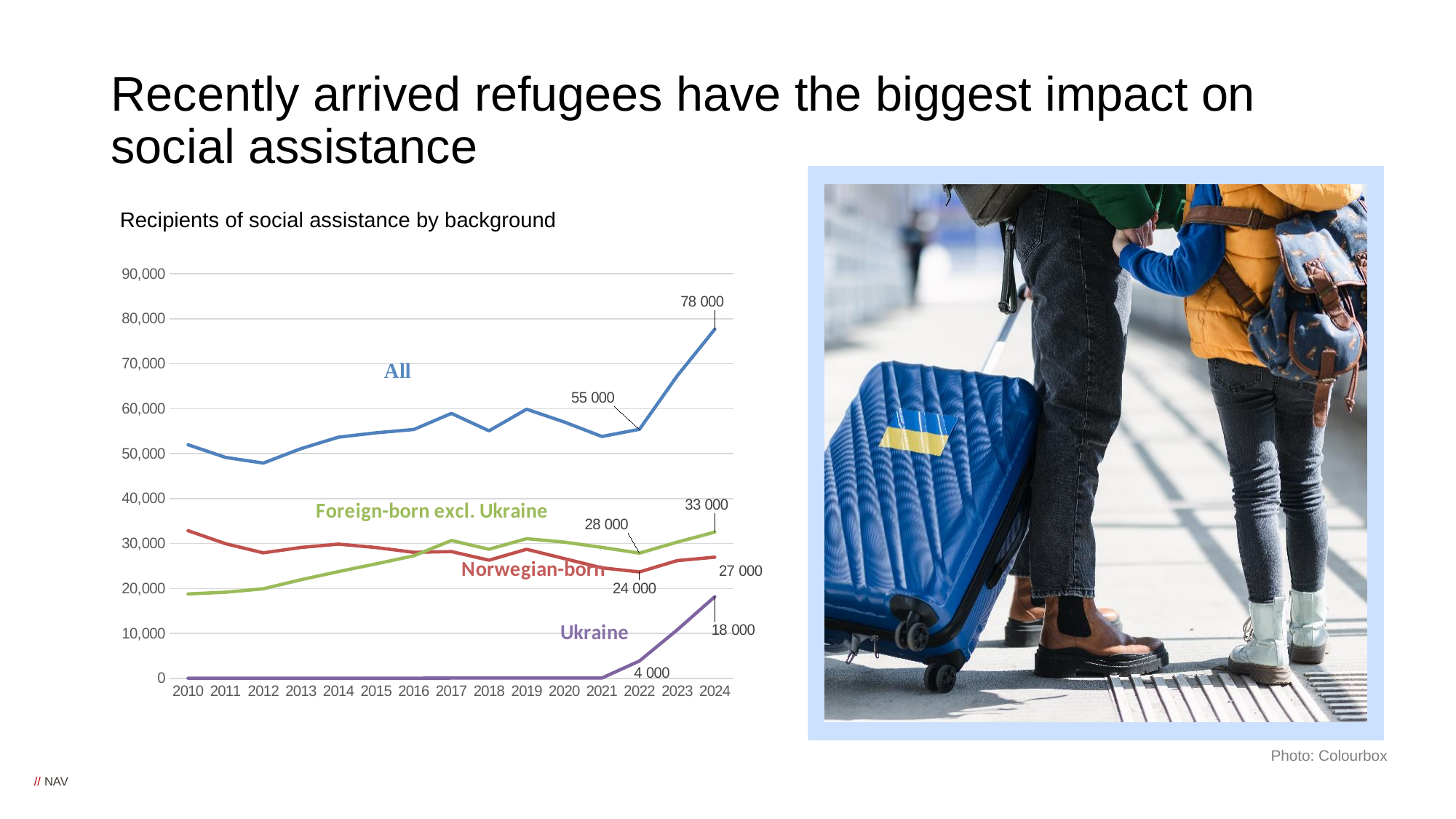
Does the Ukraine series rise or fall from 2021 to 2024? rise What kind of chart is shown on the slide? line chart What is the difference between the Ukraine values in 2024 and 2022? 14 000 What is the value for Foreign-born excl. Ukraine in 2022? 28 000 What is the value for the All series in 2024? 78 000 Is the value for the All series in 2012 greater or less than 50,000? less How many years are shown on the x axis? 15 What is the value for the Ukraine series in 2024? 18 000 By how much did the All series increase from 2022 to 2024? 23 000 What is the value for Norwegian-born in 2024? 27 000 Which series has the lowest value in 2024? Ukraine In 2024, which is larger: Foreign-born excl. Ukraine or Norwegian-born? Foreign-born excl. Ukraine